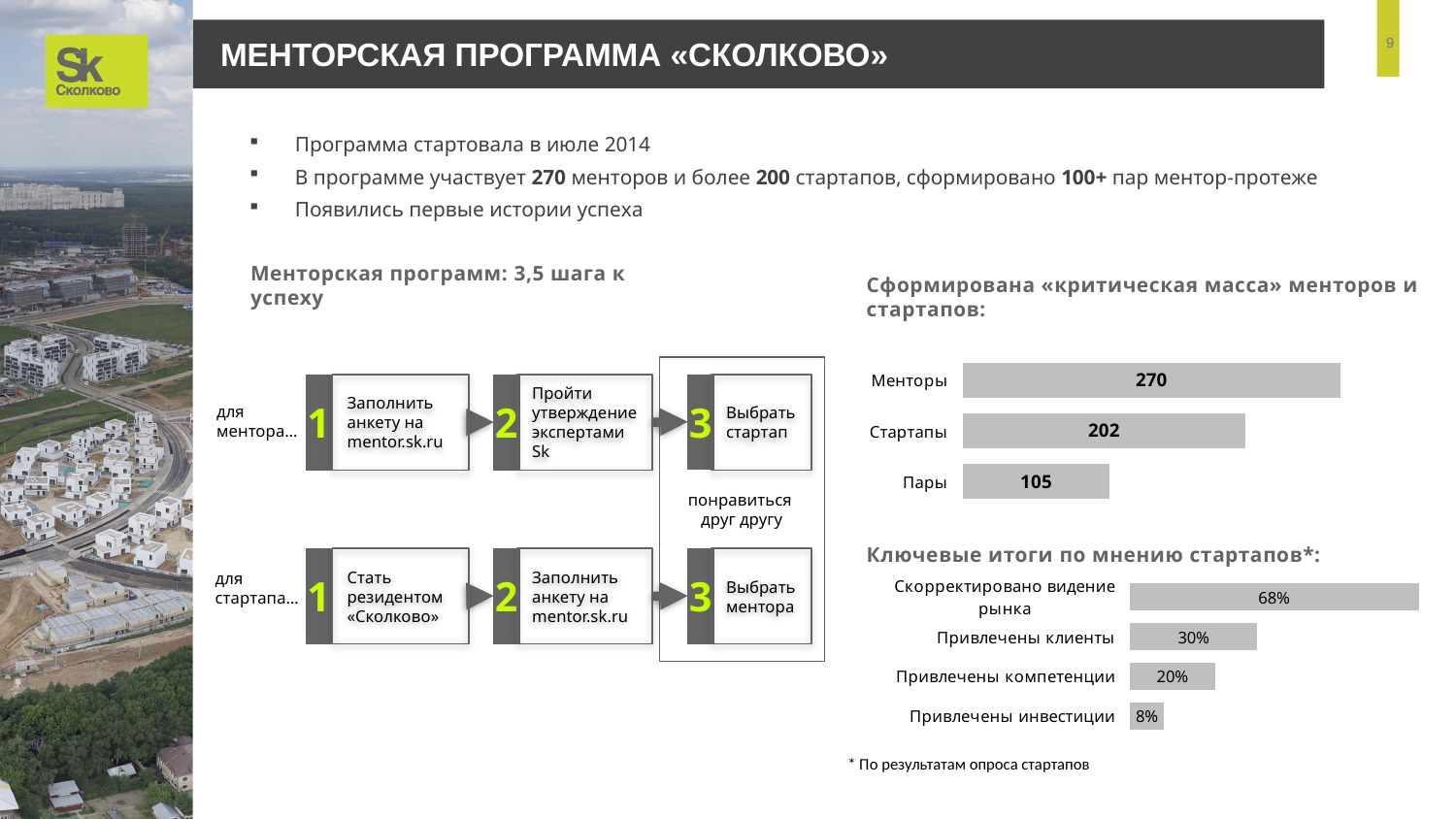
What type of chart is "Сформирована «критическая масса» менторов и стартапов"? Bar chart In the chart "Сформирована «критическая масса» менторов и стартапов", what is the value for Пары? 105 In the chart "Ключевые итоги по мнению стартапов", which category has the highest value? Скорректировано видение рынка In the chart "Сформирована «критическая масса» менторов и стартапов", what is the difference between Менторы and Стартапы? 68 In the chart "Ключевые итоги по мнению стартапов", what is the value for Привлечены клиенты? 30% In the chart "Сформирована «критическая масса» менторов и стартапов", which category has the lowest value? Пары In the chart "Ключевые итоги по мнению стартапов", what is the difference between Скорректировано видение рынка and Привлечены клиенты? 38% In the chart "Ключевые итоги по мнению стартапов", how many categories are shown? 4 In the chart "Ключевые итоги по мнению стартапов", what is the value for Привлечены инвестиции? 8% In the chart "Ключевые итоги по мнению стартапов", which is larger: Привлечены компетенции or Привлечены инвестиции? Привлечены компетенции In the chart "Сформирована «критическая масса» менторов и стартапов", how many categories are shown? 3 In the chart "Сформирована «критическая масса» менторов и стартапов", what is the value for Менторы? 270